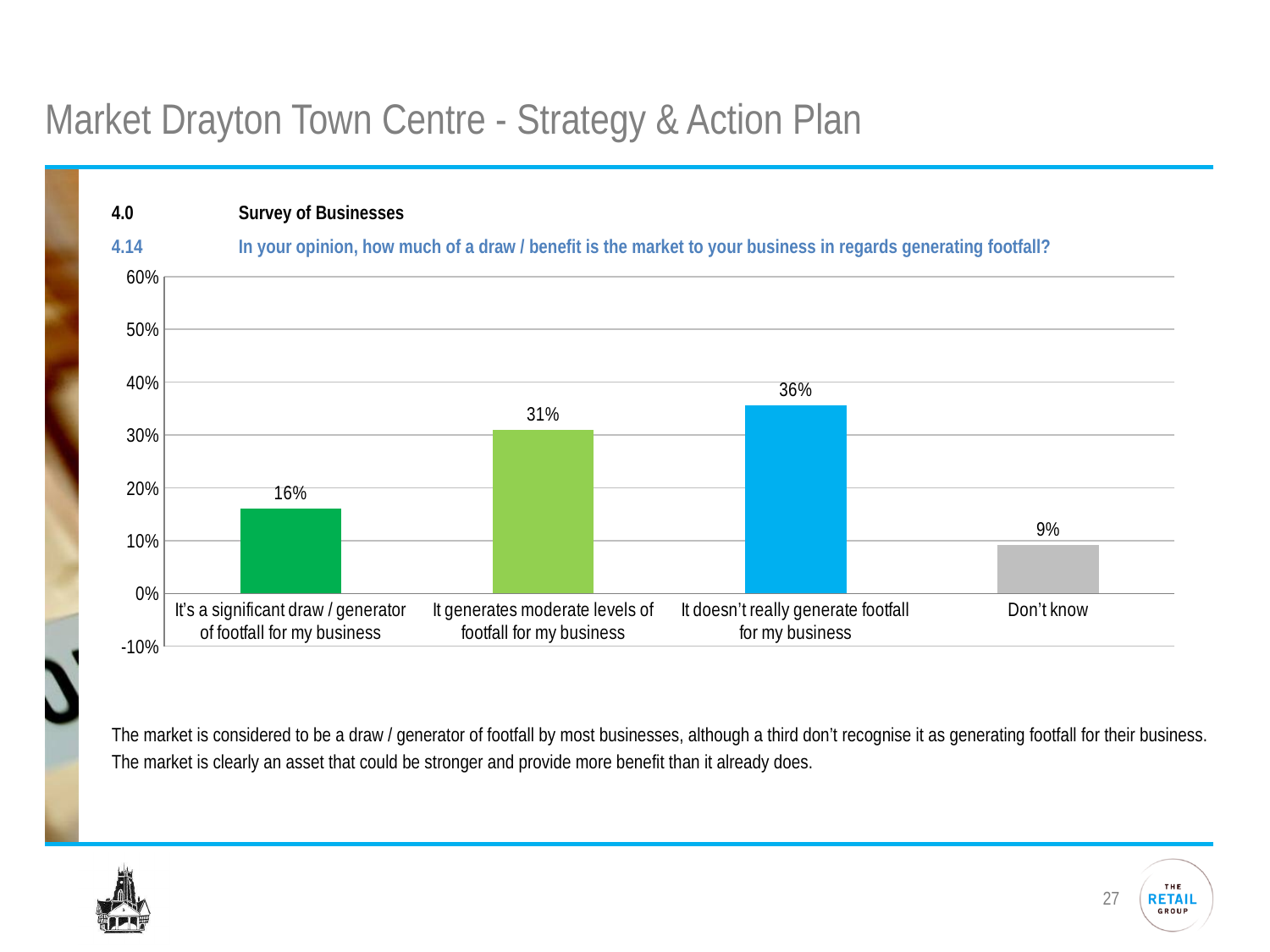
Which response category has the highest percentage? It doesn't really generate footfall for my business What is the difference in percentage points between 'It doesn't really generate footfall for my business' and 'It's a significant draw / generator of footfall for my business'? 20 percentage points What percentage of businesses answered 'Don't know'? 9% Is the value for 'It doesn't really generate footfall for my business' greater or less than 30%? greater What colour is the bar for 'Don't know'? Grey How many response categories are shown in the chart? 4 What percentage of businesses said the market generates moderate levels of footfall for their business? 31% Which is larger: the percentage for 'It generates moderate levels of footfall for my business' or for 'It's a significant draw / generator of footfall for my business'? It generates moderate levels of footfall for my business Which response category has the lowest percentage? Don't know What percentage of businesses said the market is a significant draw / generator of footfall for their business? 16% What type of chart is shown on the slide? Bar chart What percentage of businesses said the market doesn't really generate footfall for their business? 36%